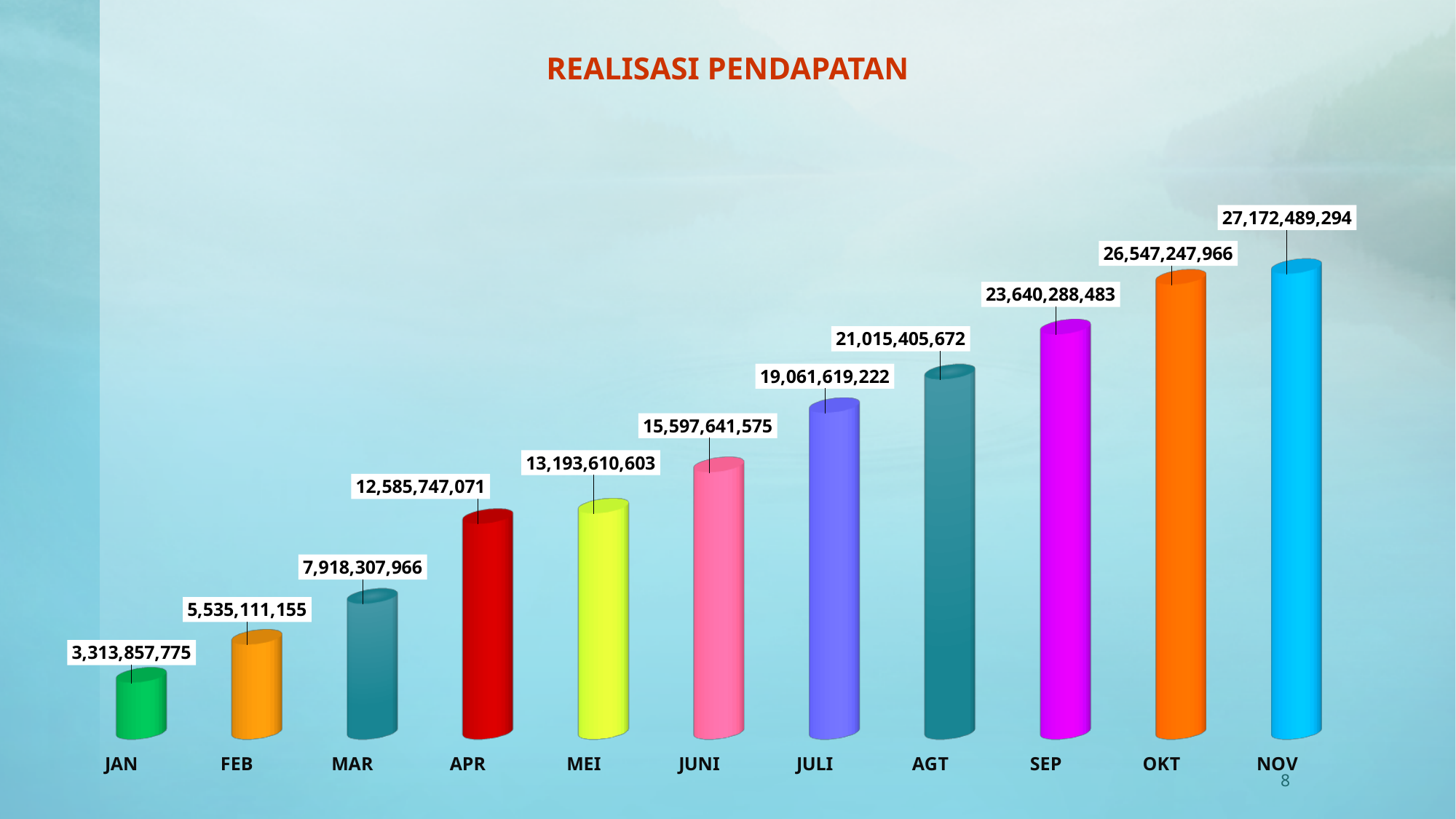
What is the difference between the values for FEB and JAN? 2,221,253,380 How many months are shown on the chart? 11 Which is larger, the value for APR or the value for MAR? APR What kind of chart is shown on the slide? Bar chart Which month has the highest value? NOV What is the difference between the values for NOV and OKT? 625,241,328 What is the value for SEP? 23,640,288,483 Which month has the lowest value? JAN What is the value for JAN? 3,313,857,775 What is the title of the chart? REALISASI PENDAPATAN Do the values rise or fall from JAN to NOV? Rise What is the value for JULI? 19,061,619,222